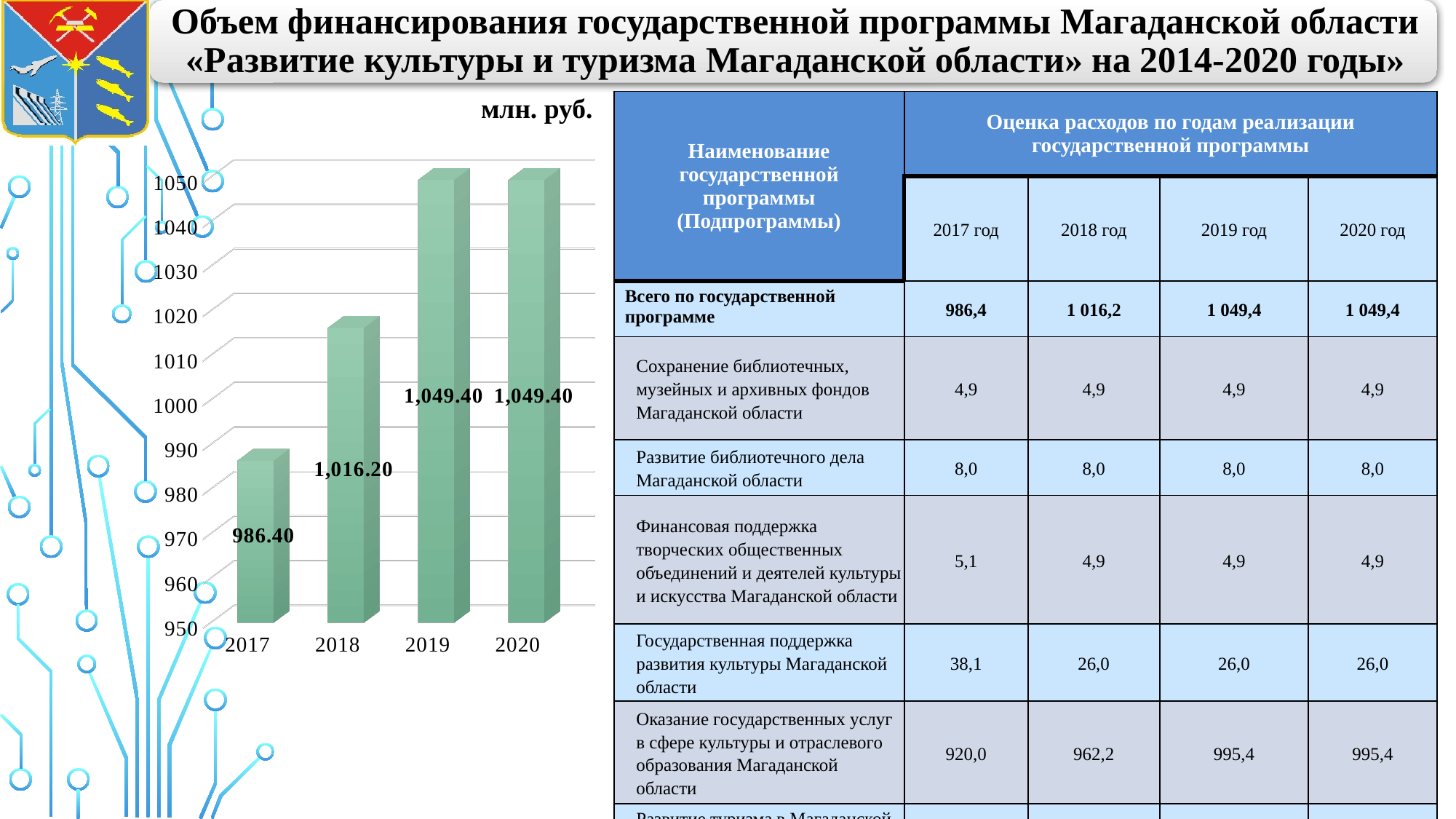
What is the value shown for 2020 on the chart? 1,049.40 Which is larger on the chart, the value for 2018 or the value for 2017? 2018 What is the difference between the values for 2018 and 2017 on the chart? 29.80 What kind of chart is shown on the slide? bar chart Is the value for 2017 on the chart greater or less than 1000? less What is the value shown for 2019 on the chart? 1,049.40 What unit label is shown above the chart? млн. руб. What is the value shown for 2018 on the chart? 1,016.20 What is the value shown for 2017 on the chart? 986.40 Which year has the lowest value on the chart? 2017 What is the difference between the values for 2019 and 2018 on the chart? 33.20 How many years are plotted on the chart? 4